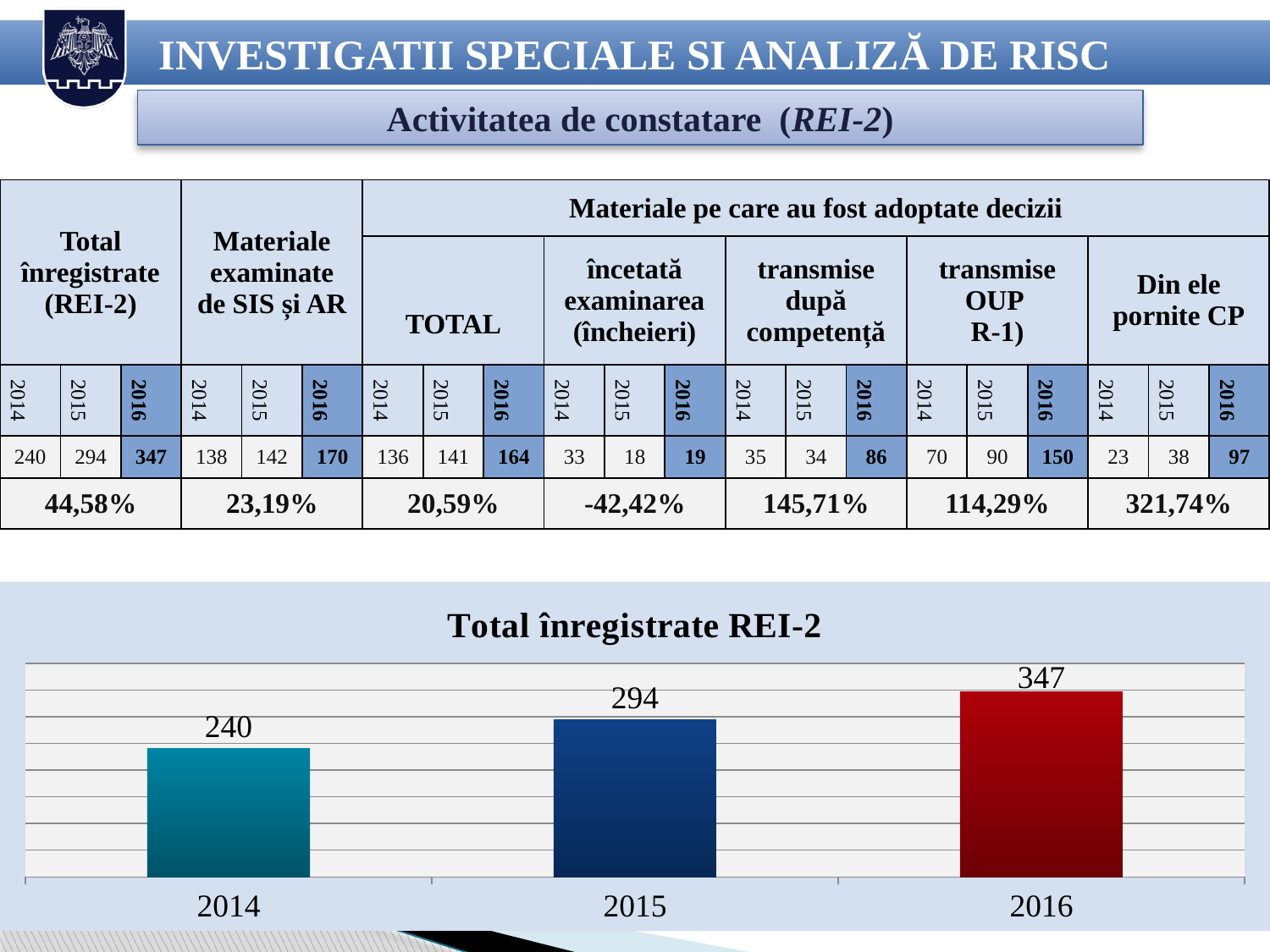
Which is larger in the chart, the value for 2015 or the value for 2016? 2016 What is the difference between the values for 2015 and 2014 in the chart? 54 Do the values in the chart rise or fall from 2014 to 2016? rise What is the value for 2015 in the chart? 294 What is the value for 2014 in the chart? 240 What is the difference between the values for 2016 and 2014 in the chart? 107 Which year has the lowest value in the chart? 2014 Which year has the highest value in the chart? 2016 What kind of chart is shown on the slide? bar chart What is the title of the chart? Total înregistrate REI-2 What is the value for 2016 in the chart? 347 How many bars are shown in the chart? 3